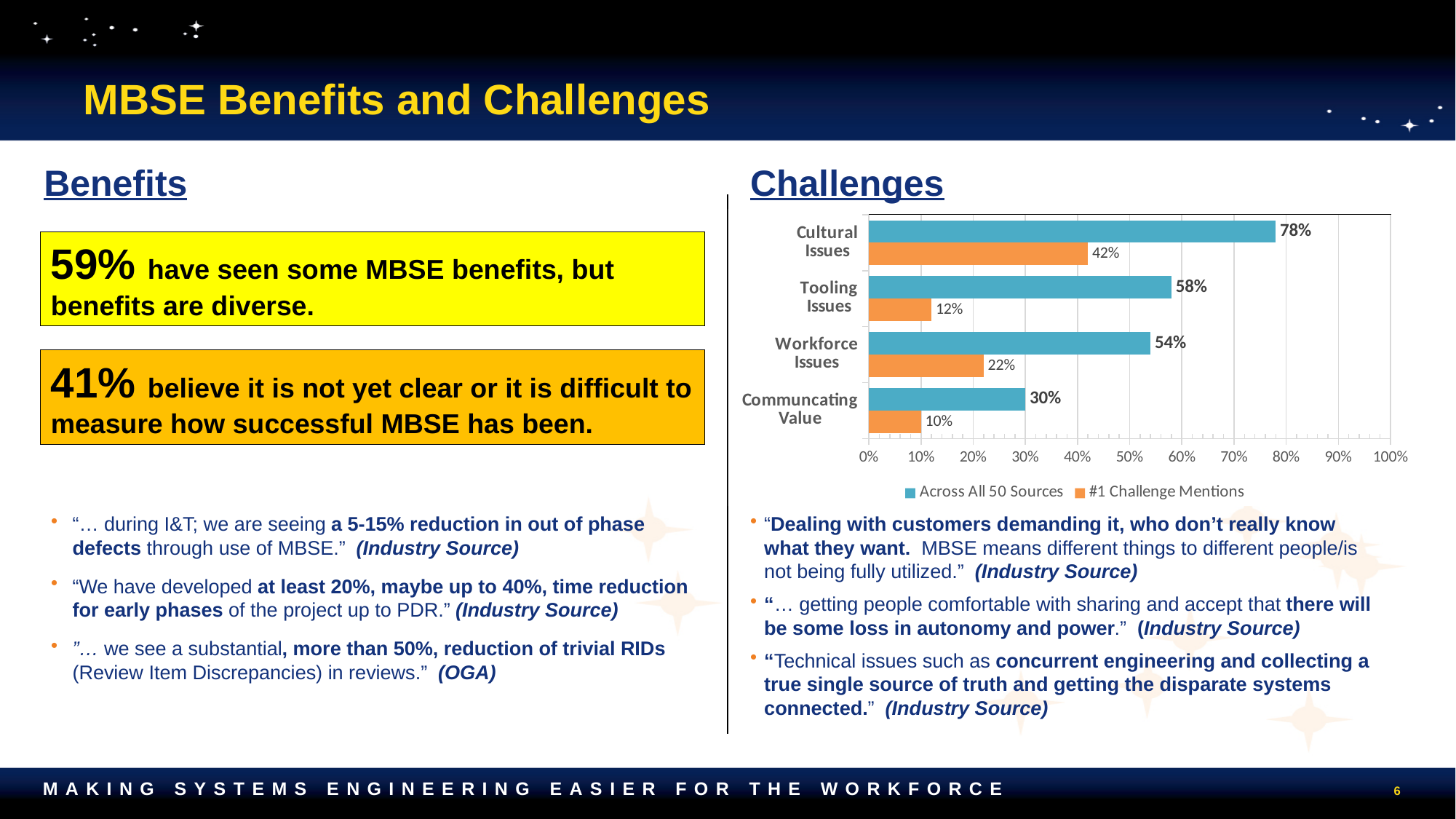
What is the value for Workforce Issues in the Across All 50 Sources series? 54% How many series does the chart legend list? 2 How many categories are shown in the chart? 4 What kind of chart is shown on the slide? Bar chart Which category has the lowest value in the #1 Challenge Mentions series? Communcating Value Which category has the highest value in the Across All 50 Sources series? Cultural Issues What is the value for Cultural Issues in the Across All 50 Sources series? 78% What is the value for Tooling Issues in the #1 Challenge Mentions series? 12% Which is larger: the #1 Challenge Mentions value for Cultural Issues or for Workforce Issues? Cultural Issues What are the two series names listed in the chart legend? Across All 50 Sources; #1 Challenge Mentions What is the difference between the Across All 50 Sources value and the #1 Challenge Mentions value for Tooling Issues? 46% What is the value for Communcating Value in the #1 Challenge Mentions series? 10%